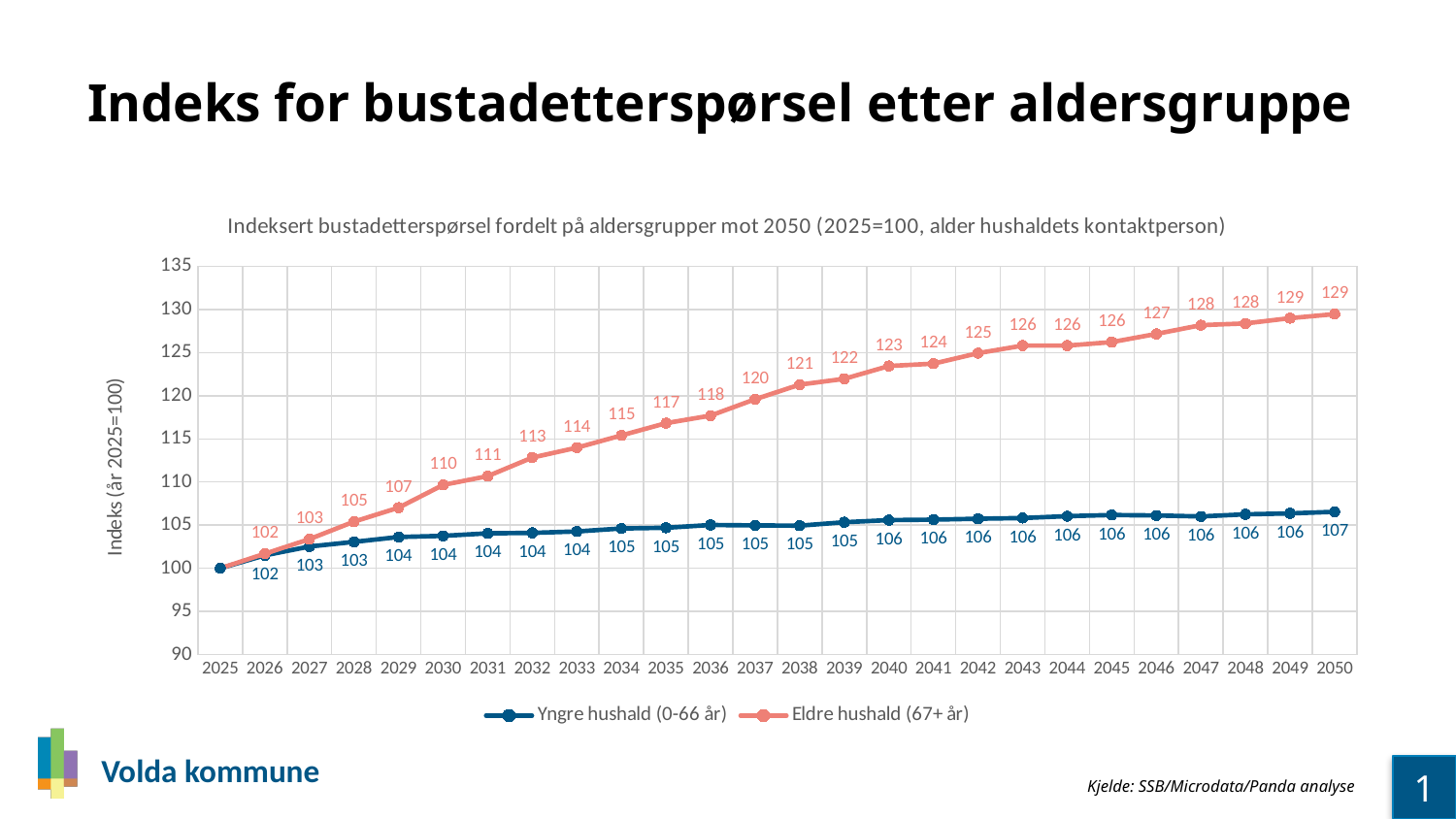
What is the value for Eldre hushald (67+ år) in 2030? 110 How many years are plotted on the x axis? 26 Is the value for Eldre hushald (67+ år) in 2045 greater or less than 125? greater Which series has the higher value in 2037, Eldre hushald (67+ år) or Yngre hushald (0-66 år)? Eldre hushald (67+ år) What is the difference between Eldre hushald (67+ år) and Yngre hushald (0-66 år) in 2050? 22 What is the value for Yngre hushald (0-66 år) in 2050? 107 What is the label of the y axis? Indeks (år 2025=100) What kind of chart is shown on the slide? Line chart What is the value for Yngre hushald (0-66 år) in 2040? 106 What is the value for Eldre hushald (67+ år) in 2050? 129 How many series does the legend list? 2 Does the value for Eldre hushald (67+ år) rise or fall from 2025 to 2050? Rise